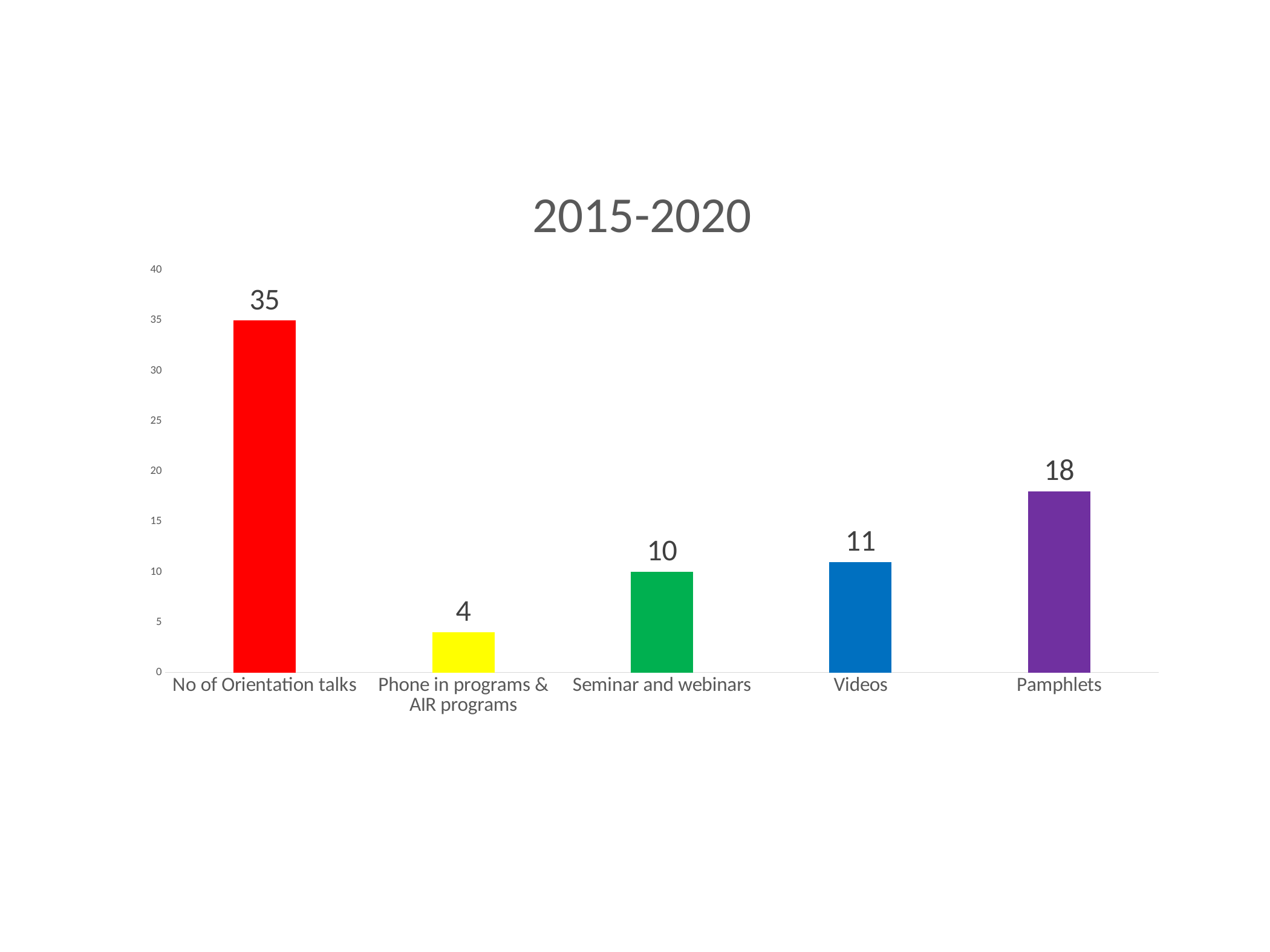
Which is larger, the value for Seminar and webinars or the value for Pamphlets? Pamphlets Which category has the lowest value? Phone in programs & AIR programs What is the difference between the values for No of Orientation talks and Pamphlets? 17 What is the value for No of Orientation talks? 35 What is the value for Phone in programs & AIR programs? 4 What is the title of the chart? 2015-2020 Which category has the highest value? No of Orientation talks What kind of chart is shown on the slide? bar chart How many categories are shown on the chart? 5 What is the value for Pamphlets? 18 What is the value for Videos? 11 Is the value for Pamphlets greater or less than 20? less